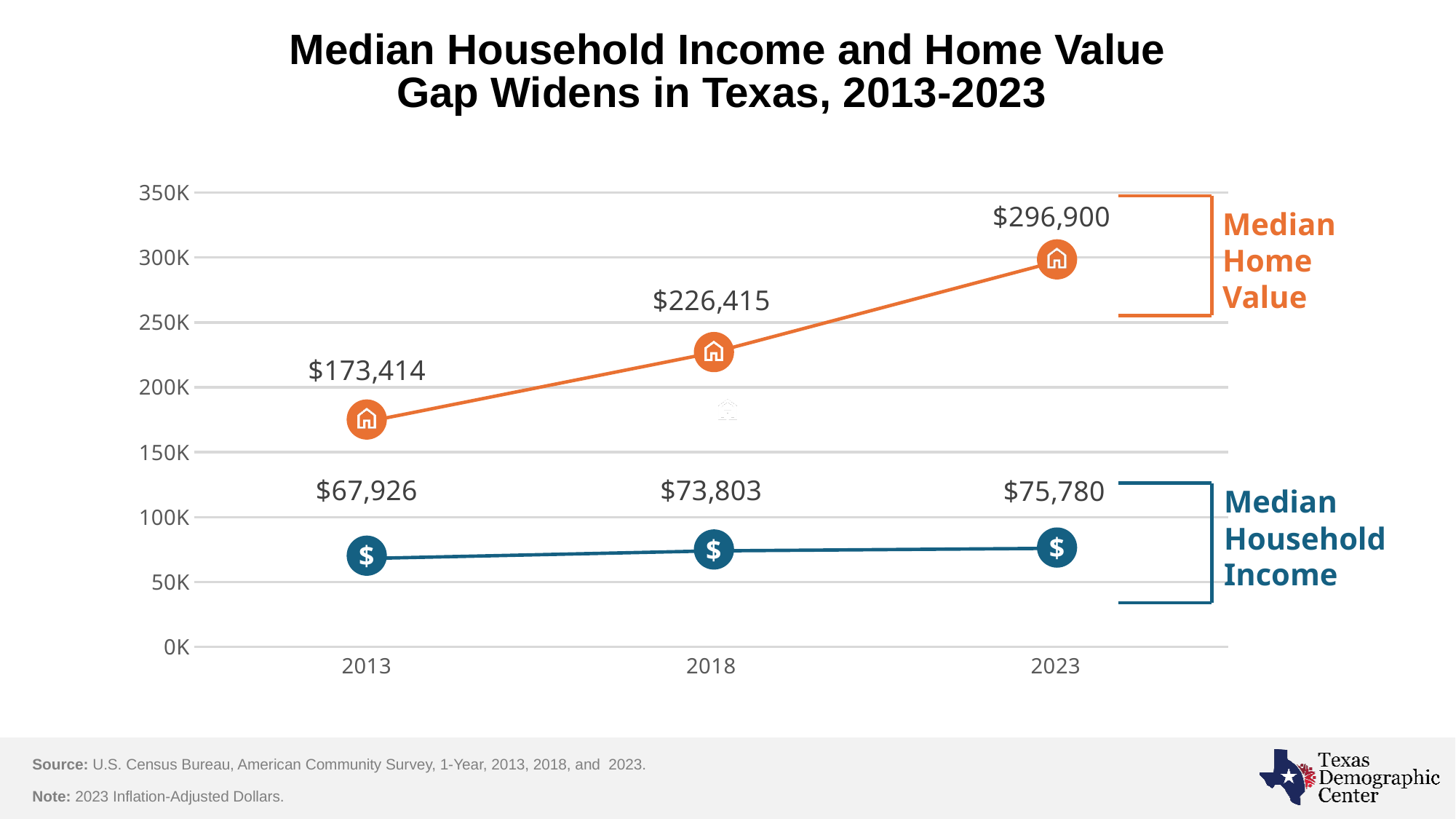
What is the difference between the Median Household Income in 2018 and in 2013? $5,877 What is the difference between the Median Home Value in 2023 and in 2013? $123,486 What is the Median Home Value in 2018? $226,415 What is the Median Household Income in 2013? $67,926 What kind of chart is shown on the slide? Line chart What is the Median Household Income in 2023? $75,780 What is the Median Home Value in 2023? $296,900 Which is larger in 2018: the Median Home Value or the Median Household Income? Median Home Value How many years are plotted on the x axis? 3 In which year is the Median Home Value highest? 2023 Does the Median Home Value rise or fall from 2013 to 2023? Rise In which year is the Median Household Income lowest? 2013